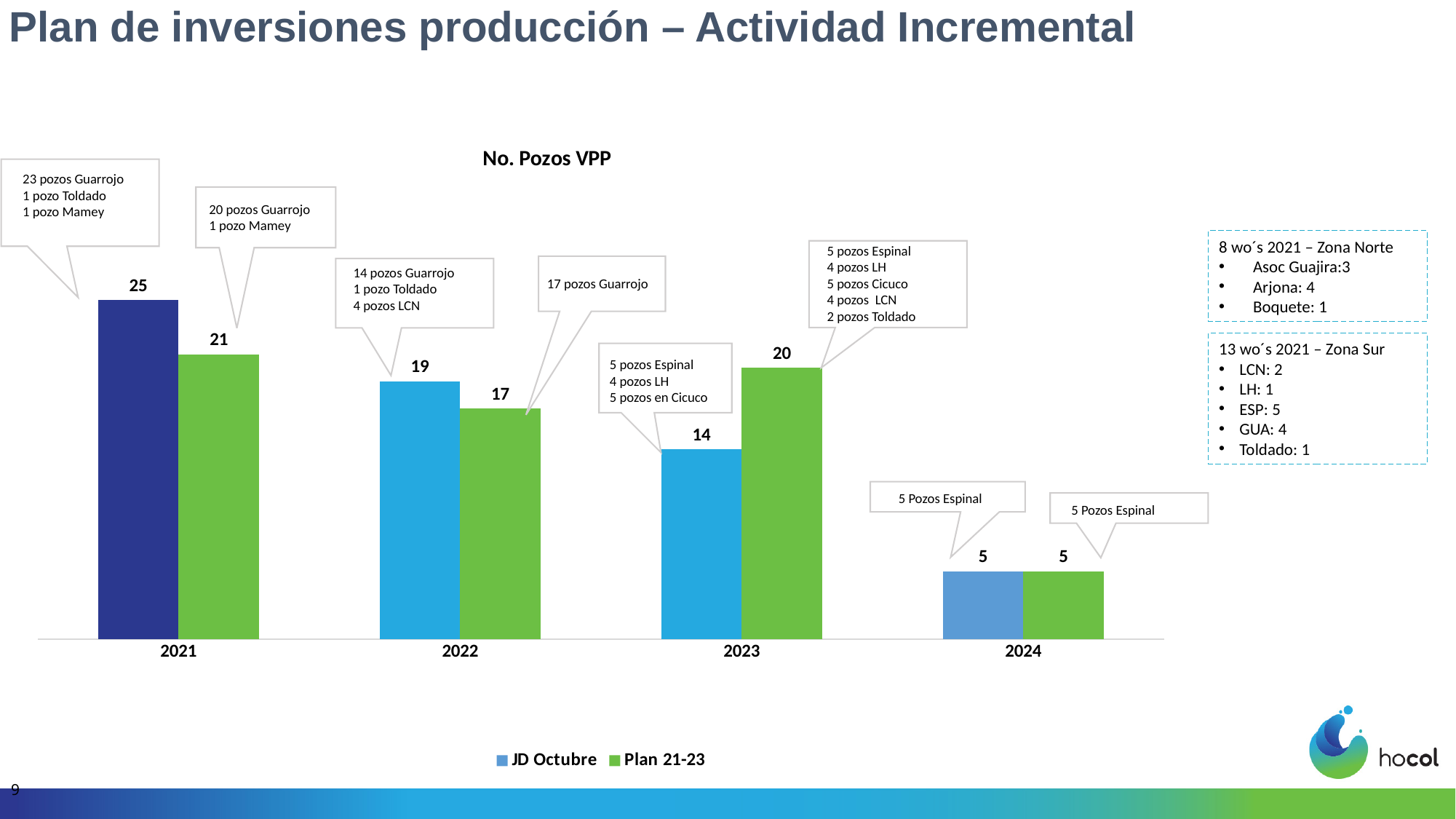
What is the difference between the JD Octubre and Plan 21-23 values for 2022 in the No. Pozos VPP chart? 2 Which year has the lowest Plan 21-23 value in the No. Pozos VPP chart? 2024 How many years are shown on the x axis of the No. Pozos VPP chart? 4 Do the JD Octubre values rise or fall from 2021 to 2024 in the No. Pozos VPP chart? Fall What kind of chart is the No. Pozos VPP chart? Bar chart Which year has the highest JD Octubre value in the No. Pozos VPP chart? 2021 How many series does the legend of the No. Pozos VPP chart list? 2 What is the title of the chart on the slide? No. Pozos VPP What is the JD Octubre value for 2021 in the No. Pozos VPP chart? 25 What is the JD Octubre value for 2023 in the No. Pozos VPP chart? 14 In 2023, which series has the larger value in the No. Pozos VPP chart, JD Octubre or Plan 21-23? Plan 21-23 What is the Plan 21-23 value for 2023 in the No. Pozos VPP chart? 20